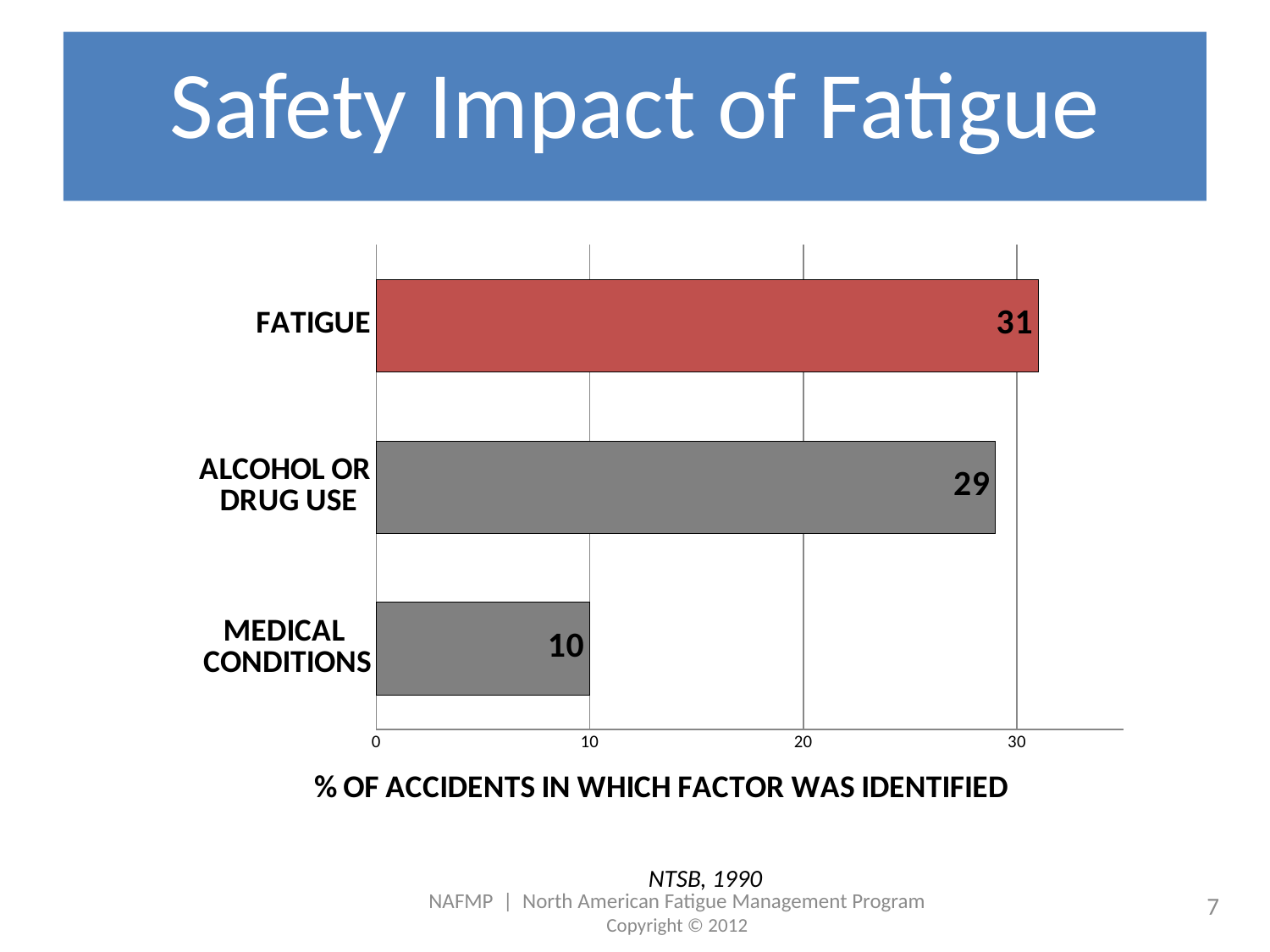
Which is larger, the value for FATIGUE or the value for MEDICAL CONDITIONS? FATIGUE How many categories are shown in the chart? 3 Is the value for ALCOHOL OR DRUG USE greater or less than 20? greater Which category has the lowest value? MEDICAL CONDITIONS What is the value for FATIGUE? 31 What is the difference between the values for FATIGUE and ALCOHOL OR DRUG USE? 2 What is the value for ALCOHOL OR DRUG USE? 29 What is the difference between the values for ALCOHOL OR DRUG USE and MEDICAL CONDITIONS? 19 Which category has the highest value? FATIGUE What is the value for MEDICAL CONDITIONS? 10 What is the label of the horizontal axis? % OF ACCIDENTS IN WHICH FACTOR WAS IDENTIFIED What kind of chart is shown on the slide? bar chart